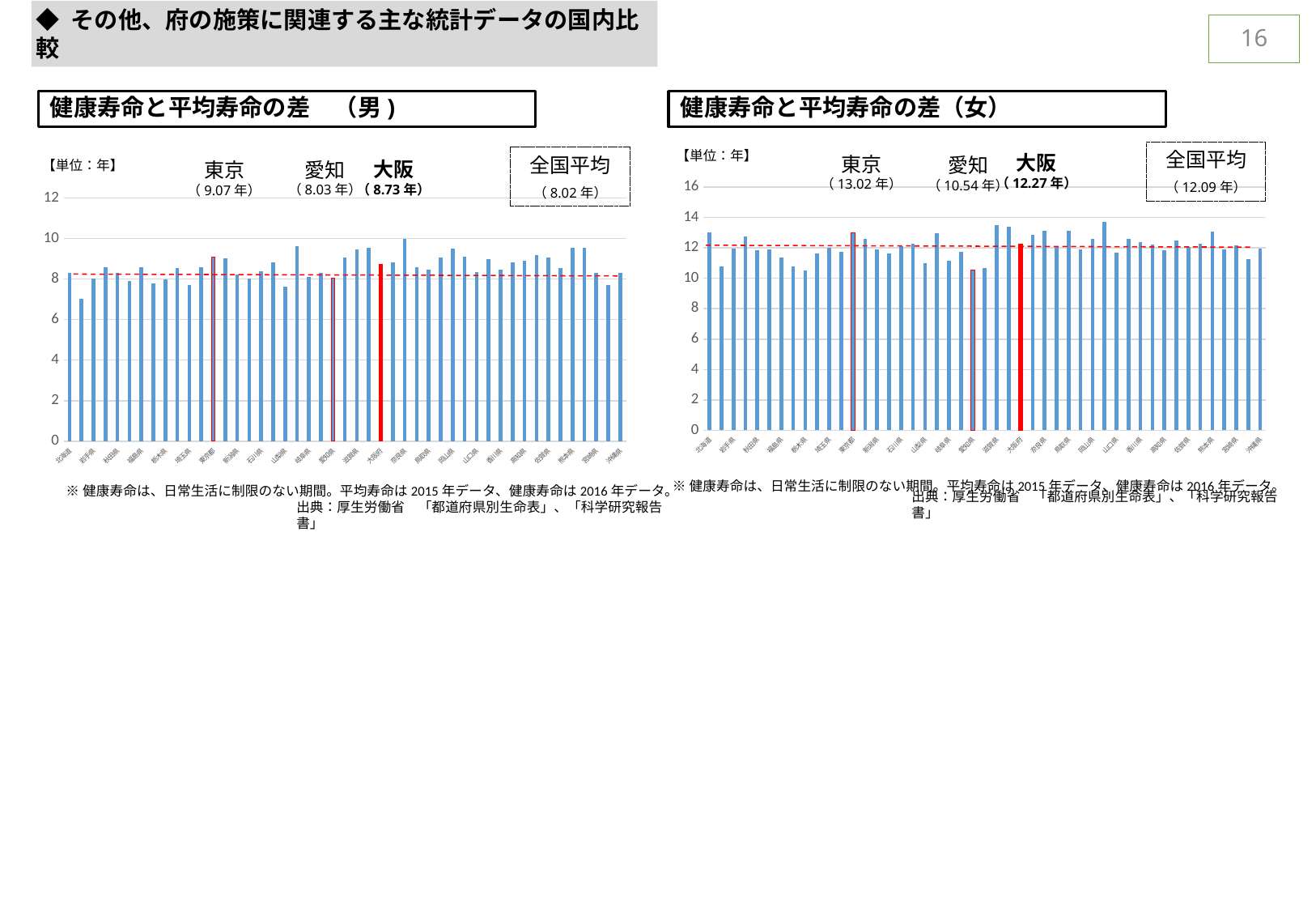
In the right chart (女), what is the value shown for 大阪? 12.27年 In the left chart (男), what is the value shown for 東京? 9.07年 What kind of chart is the left chart titled 健康寿命と平均寿命の差（男）? bar chart In the left chart (男), which has the larger value, 大阪 or 愛知? 大阪 In the right chart (女), what is the difference between the values for 大阪 and 愛知? 1.73年 In the left chart (男), what is the value shown for 大阪? 8.73年 In the right chart (女), what is the value shown for 東京? 13.02年 In the left chart (男), what is the value shown for 愛知? 8.03年 In the right chart (女), what is the 全国平均 value? 12.09年 In the left chart (男), what is the 全国平均 value? 8.02年 In the left chart (男), what is the difference between the values for 東京 and 大阪? 0.34年